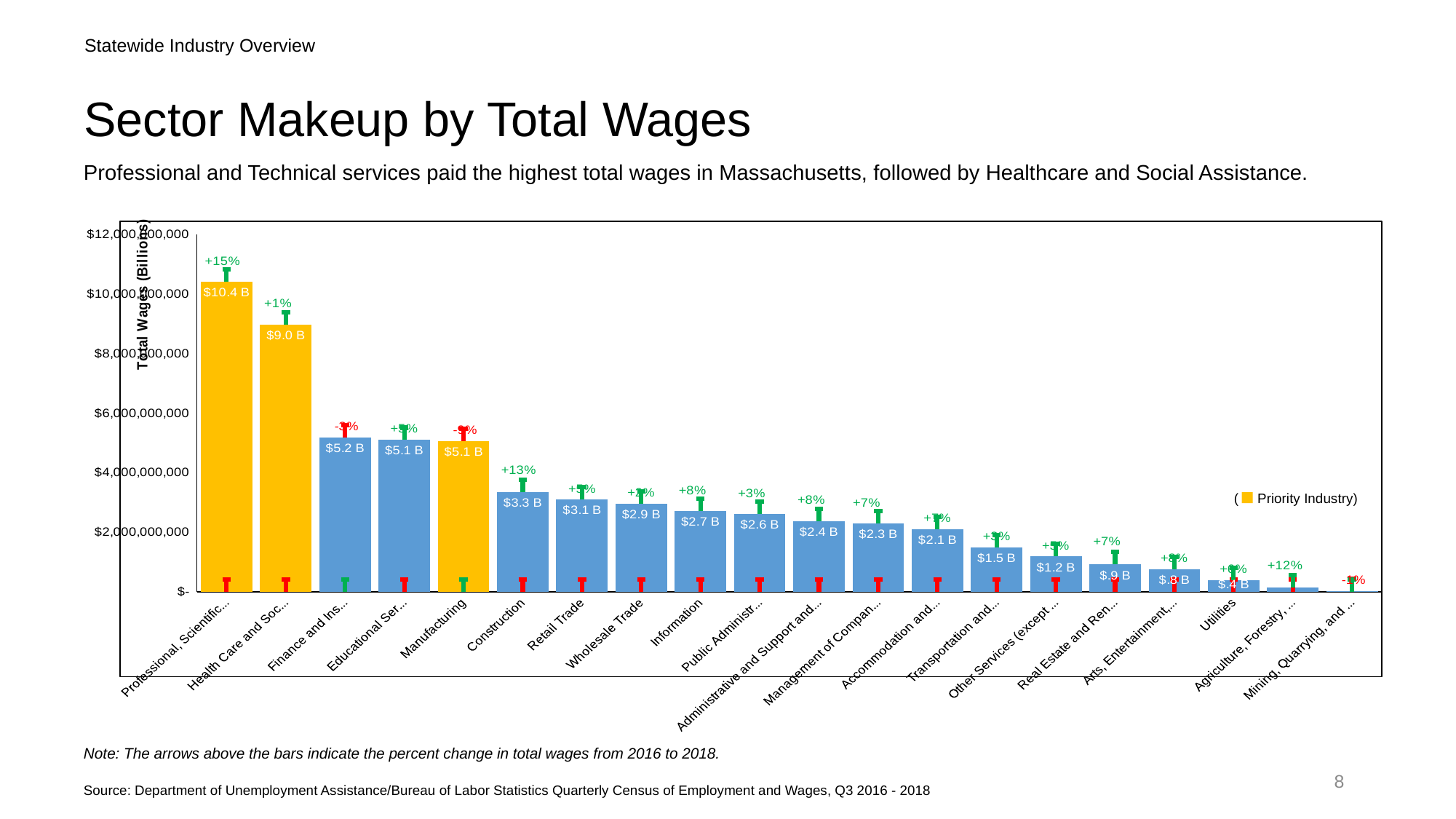
What is the total wages value for Construction? $3.3 B What is the total wages value for Information? $2.7 B Is the value for Utilities greater or less than $2,000,000,000? less What is the difference in total wages between Professional, Scientific... and Health Care and Soc...? $1.4 B How many bars are coloured yellow as Priority Industry? 3 Which has higher total wages, Retail Trade or Wholesale Trade? Retail Trade Which sector has the highest total wages? Professional, Scientific... What is the total wages value for Manufacturing? $5.1 B What percent change in total wages is shown above the Construction bar? +13% How many sectors are shown on the x axis? 20 What kind of chart is shown on the slide? bar chart Do the total wages values rise or fall moving left to right along the x axis? fall